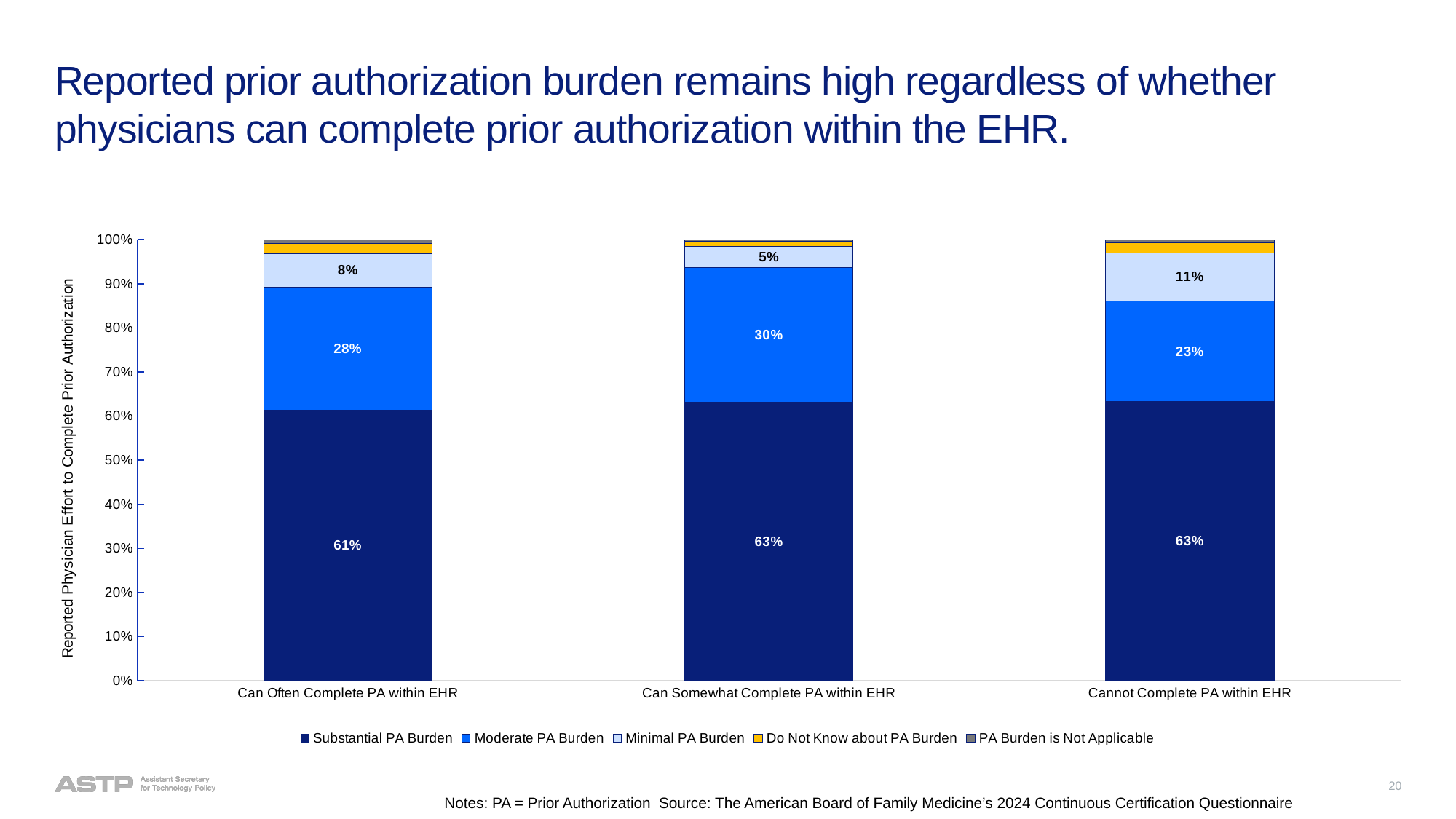
How many series does the chart legend list? 5 Is the Substantial PA Burden value for the 'Cannot Complete PA within EHR' group greater or less than 50%? greater Which group has a larger Substantial PA Burden share: 'Can Often Complete PA within EHR' or 'Can Somewhat Complete PA within EHR'? Can Somewhat Complete PA within EHR Which group has the lowest Moderate PA Burden percentage? Cannot Complete PA within EHR What is the difference in Moderate PA Burden between the 'Can Somewhat Complete PA within EHR' group and the 'Cannot Complete PA within EHR' group? 7 percentage points What percentage of physicians who can often complete PA within the EHR report a substantial PA burden? 61% What type of chart is shown on the slide? Stacked bar chart What is the title of the chart's vertical axis? Reported Physician Effort to Complete Prior Authorization What is the Minimal PA Burden value for the 'Can Somewhat Complete PA within EHR' group? 5% Which group has the highest Minimal PA Burden percentage? Cannot Complete PA within EHR How many groups (categories) are shown on the x axis of the chart? 3 What is the Moderate PA Burden value for the 'Cannot Complete PA within EHR' group? 23%